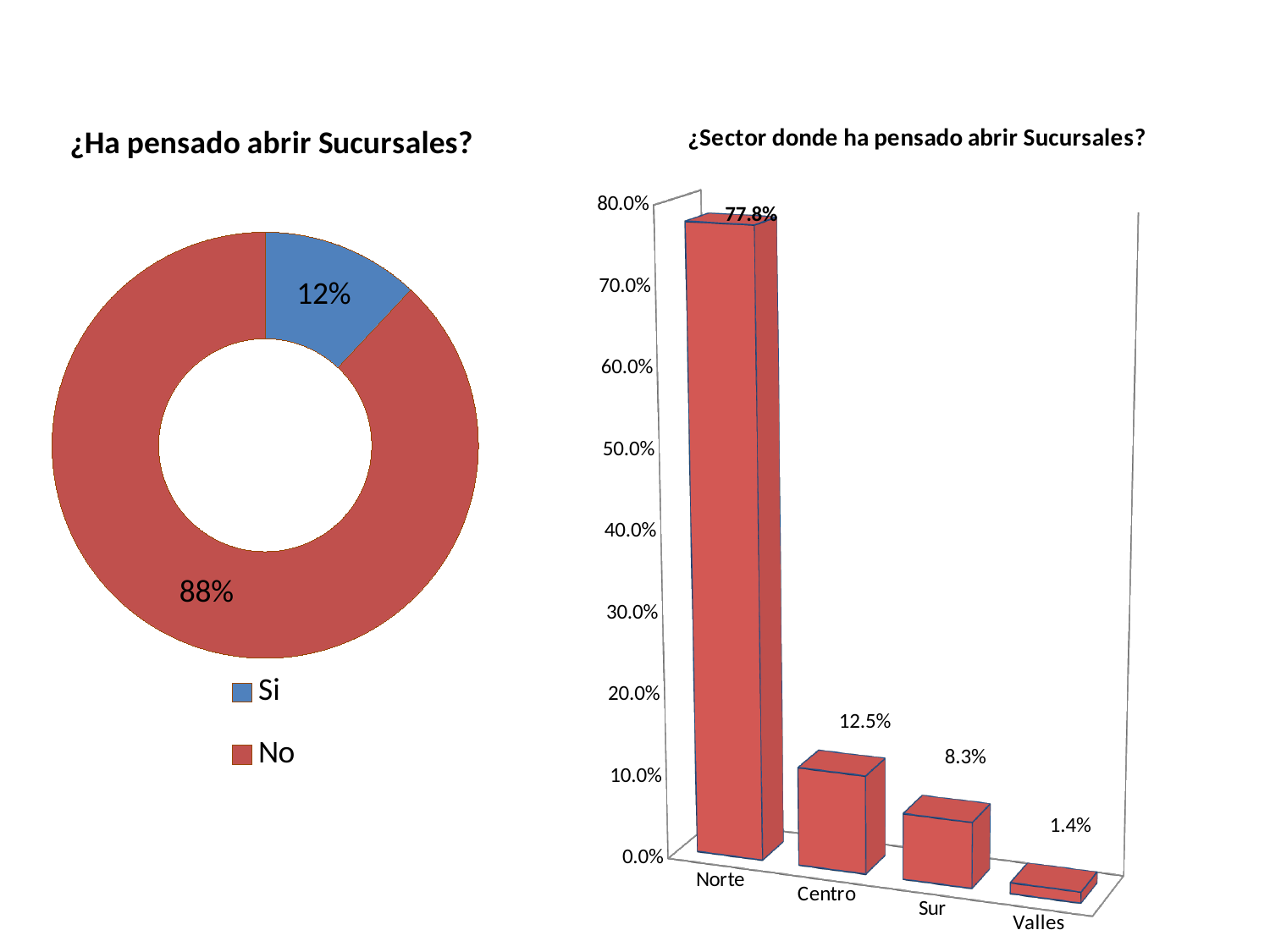
In the chart titled "¿Ha pensado abrir Sucursales?", what kind of chart is shown? Doughnut chart In the chart titled "¿Ha pensado abrir Sucursales?", what percentage answered "Si"? 12% In the chart titled "¿Ha pensado abrir Sucursales?", which answer has the larger share? No In the chart titled "¿Sector donde ha pensado abrir Sucursales?", how many sectors are shown? 4 In the chart titled "¿Sector donde ha pensado abrir Sucursales?", what is the difference between Centro and Sur? 4.2% In the chart titled "¿Ha pensado abrir Sucursales?", how many entries does the legend list? 2 In the chart titled "¿Sector donde ha pensado abrir Sucursales?", which sector has the lowest value? Valles In the chart titled "¿Sector donde ha pensado abrir Sucursales?", what is the value for Centro? 12.5% In the chart titled "¿Sector donde ha pensado abrir Sucursales?", do the values rise or fall from Norte to Valles? Fall In the chart titled "¿Ha pensado abrir Sucursales?", what percentage answered "No"? 88% In the chart titled "¿Sector donde ha pensado abrir Sucursales?", what is the value for Norte? 77.8% In the chart titled "¿Sector donde ha pensado abrir Sucursales?", what is the value for Valles? 1.4%